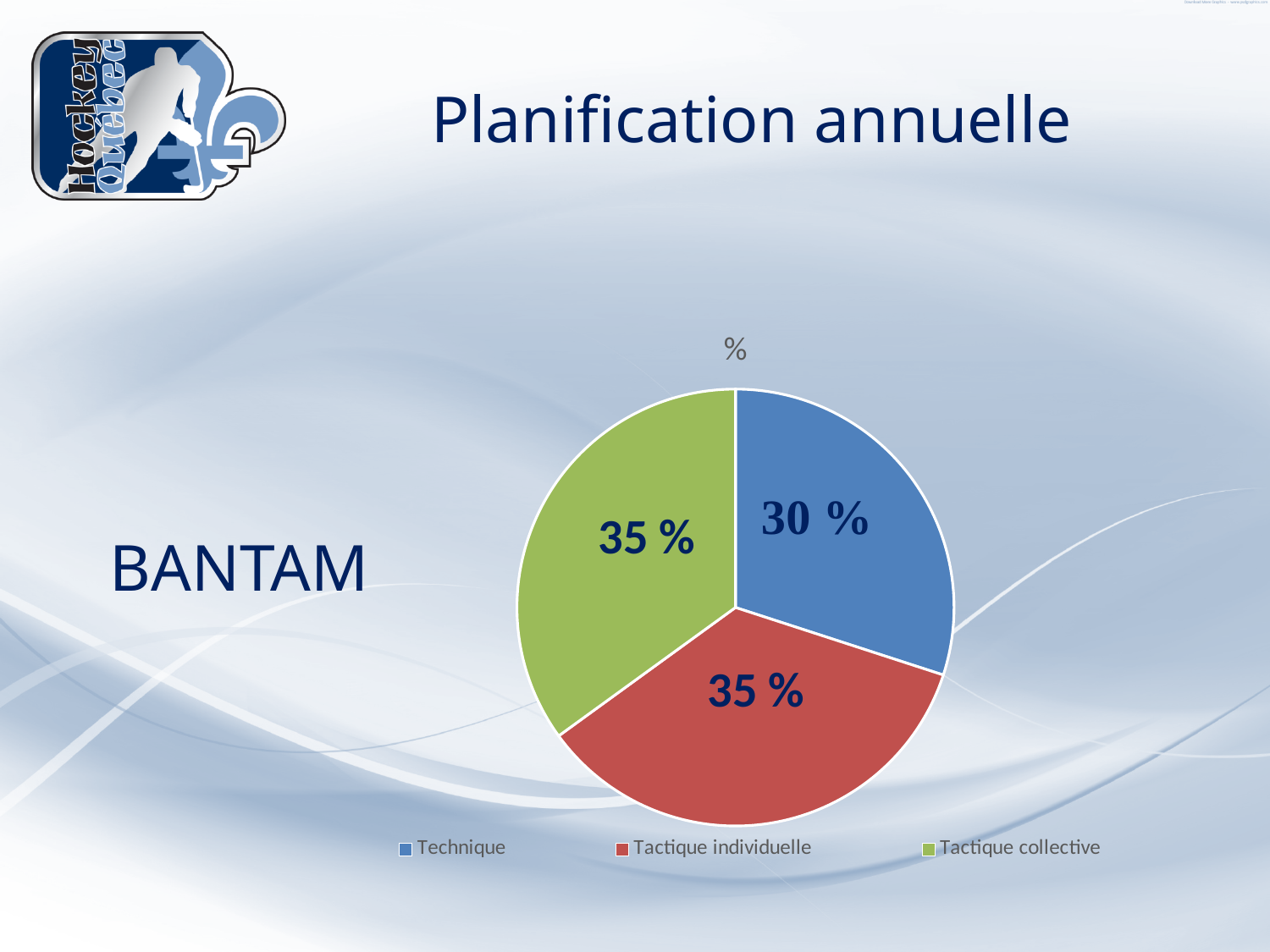
What is the title shown above the pie chart? % What is the value for Tactique collective? 35 % How many entries does the legend list? 3 What is the value for Tactique individuelle? 35 % How many slices does the pie chart have? 3 What kind of chart is shown on the slide? pie chart Which is larger, the value for Tactique collective or the value for Technique? Tactique collective What colour is the Tactique individuelle slice? red What is the value for Technique? 30 % What is the difference between the values for Tactique individuelle and Technique? 5 % Which category has the smallest slice? Technique What is the combined share of Tactique individuelle and Tactique collective? 70 %